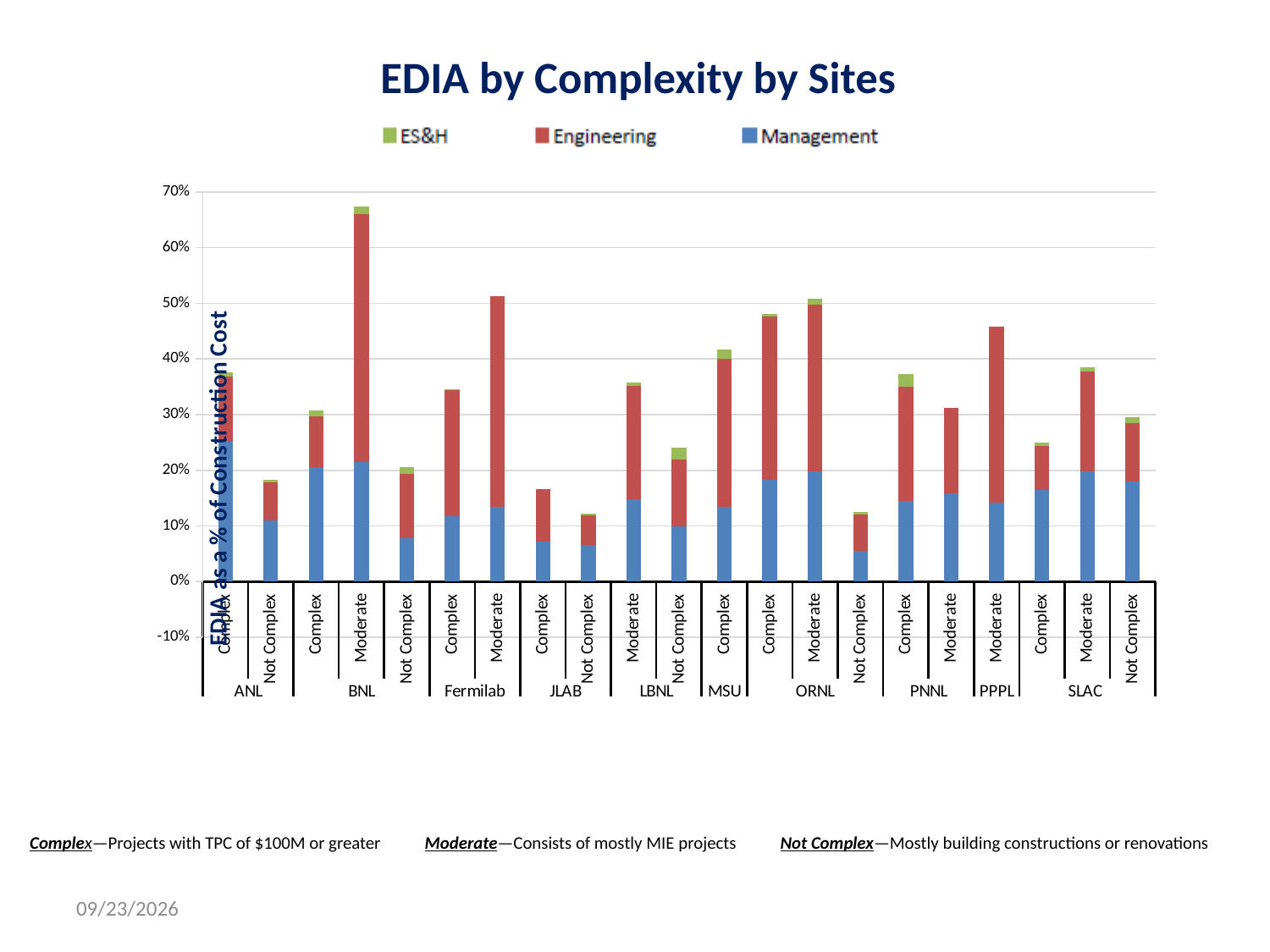
How many bars are plotted in the chart? 21 Is the total value for ORNL Not Complex greater or less than 20%? less Is the total value for PPPL Moderate greater or less than 40%? greater How many series does the legend list? 3 Which has the larger total, ANL Complex or ANL Not Complex? ANL Complex Is the total value for BNL Moderate greater or less than 60%? greater Which bar has the highest total EDIA percentage? BNL Moderate Which series are listed in the legend? ES&H, Engineering, Management What kind of chart is shown on the slide? Stacked bar chart Which has the larger total, BNL Moderate or Fermilab Moderate? BNL Moderate What is the title of the vertical axis? EDIA as a % of Construction Cost